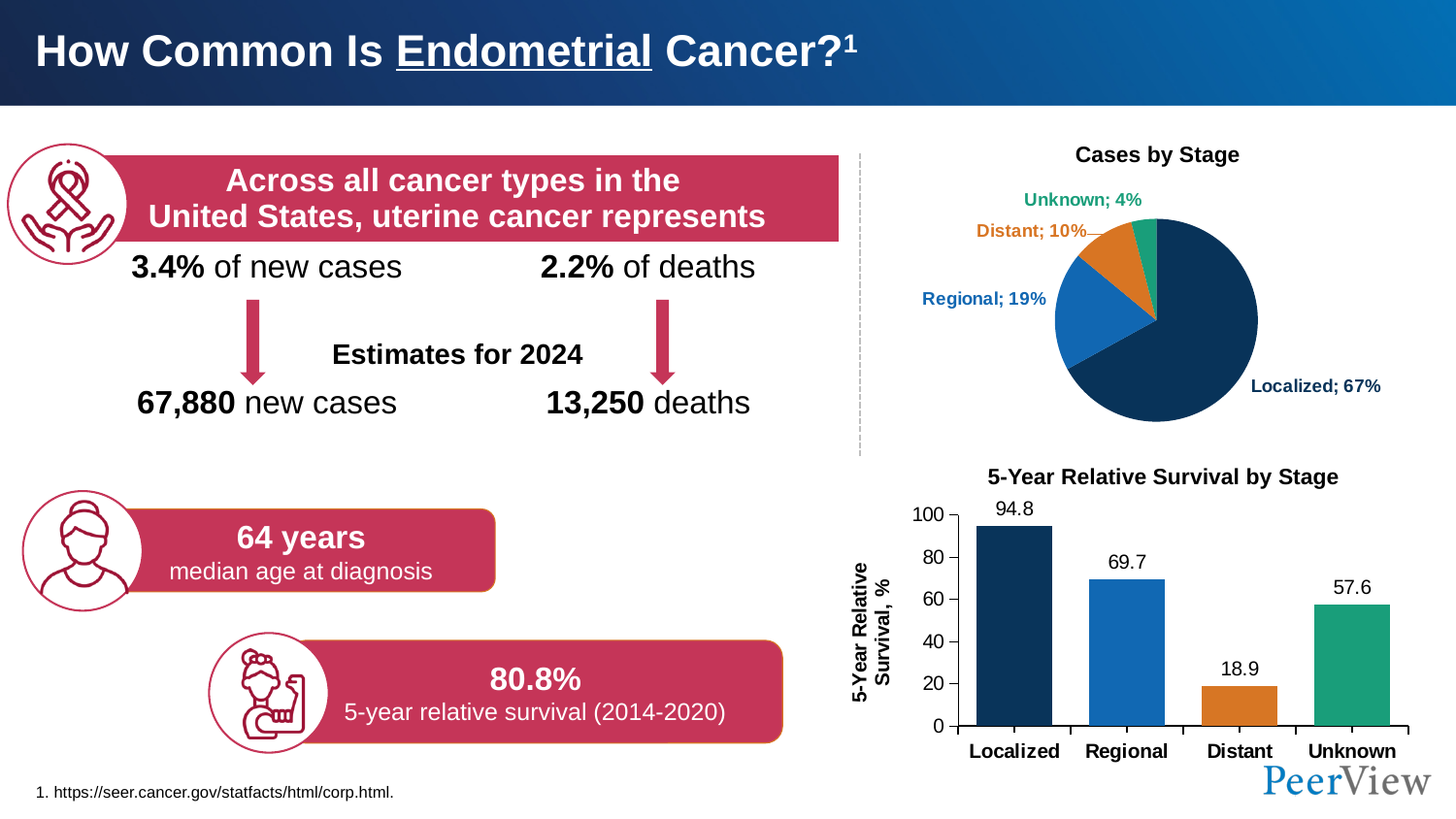
In the '5-Year Relative Survival by Stage' chart, what is the difference between the Localized and Unknown values? 37.2 In the '5-Year Relative Survival by Stage' chart, which stage has the highest survival? Localized In the 'Cases by Stage' pie chart, which stage has the smallest slice? Unknown In the 'Cases by Stage' pie chart, what share of cases is Localized? 67% What kind of chart is '5-Year Relative Survival by Stage'? Bar chart In the 'Cases by Stage' pie chart, how many slices are there? 4 In the 'Cases by Stage' pie chart, what is the difference in percentage points between the Distant and Unknown slices? 6 In the '5-Year Relative Survival by Stage' chart, what is the value for Distant? 18.9 In the '5-Year Relative Survival by Stage' chart, what is the value for Regional? 69.7 In the '5-Year Relative Survival by Stage' chart, which stage has the lowest survival? Distant In the '5-Year Relative Survival by Stage' chart, which is larger, the value for Regional or the value for Unknown? Regional In the 'Cases by Stage' pie chart, what share of cases is Regional? 19%